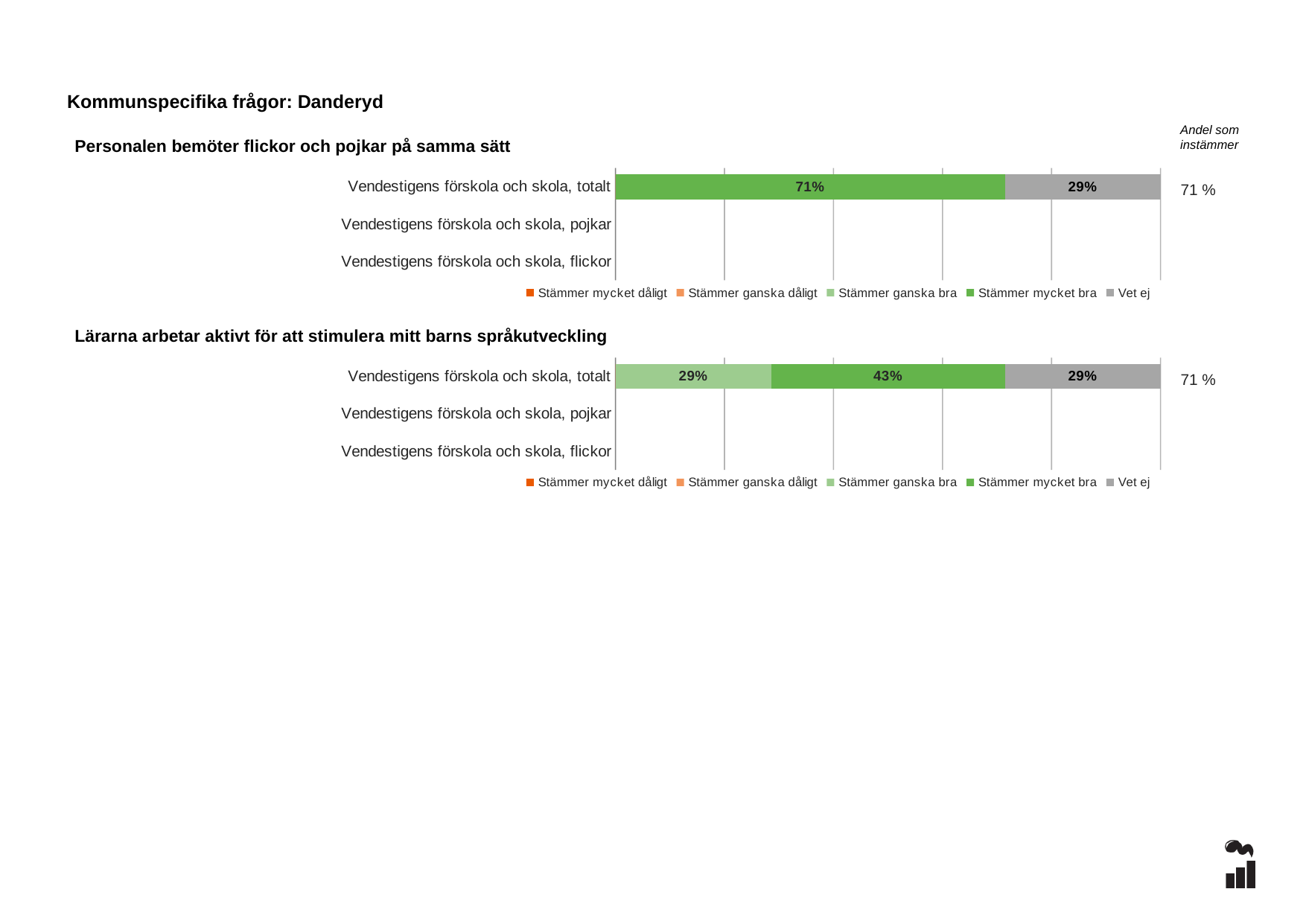
In the chart 'Lärarna arbetar aktivt för att stimulera mitt barns språkutveckling', what is the difference between 'Stämmer mycket bra' and 'Vet ej' for the totalt row? 14% In the chart 'Personalen bemöter flickor och pojkar på samma sätt', what is the difference between 'Stämmer mycket bra' and 'Vet ej' for the totalt row? 42% What is the 'Andel som instämmer' value shown next to the chart 'Lärarna arbetar aktivt för att stimulera mitt barns språkutveckling'? 71 % In the chart 'Lärarna arbetar aktivt för att stimulera mitt barns språkutveckling', what is the value for 'Stämmer mycket bra' for Vendestigens förskola och skola, totalt? 43% In the chart 'Personalen bemöter flickor och pojkar på samma sätt', what is the value for 'Vet ej' for Vendestigens förskola och skola, totalt? 29% In the chart 'Lärarna arbetar aktivt för att stimulera mitt barns språkutveckling', which is larger for the totalt row: 'Stämmer mycket bra' or 'Stämmer ganska bra'? Stämmer mycket bra In the chart 'Lärarna arbetar aktivt för att stimulera mitt barns språkutveckling', what is the value for 'Vet ej' for Vendestigens förskola och skola, totalt? 29% In the chart 'Personalen bemöter flickor och pojkar på samma sätt', what is the value for 'Stämmer mycket bra' for Vendestigens förskola och skola, totalt? 71% How many series does the legend of the chart 'Personalen bemöter flickor och pojkar på samma sätt' list? 5 How many categories are shown on the y axis of the chart 'Lärarna arbetar aktivt för att stimulera mitt barns språkutveckling'? 3 What kind of chart is 'Personalen bemöter flickor och pojkar på samma sätt'? Stacked bar chart In the chart 'Lärarna arbetar aktivt för att stimulera mitt barns språkutveckling', what is the value for 'Stämmer ganska bra' for Vendestigens förskola och skola, totalt? 29%